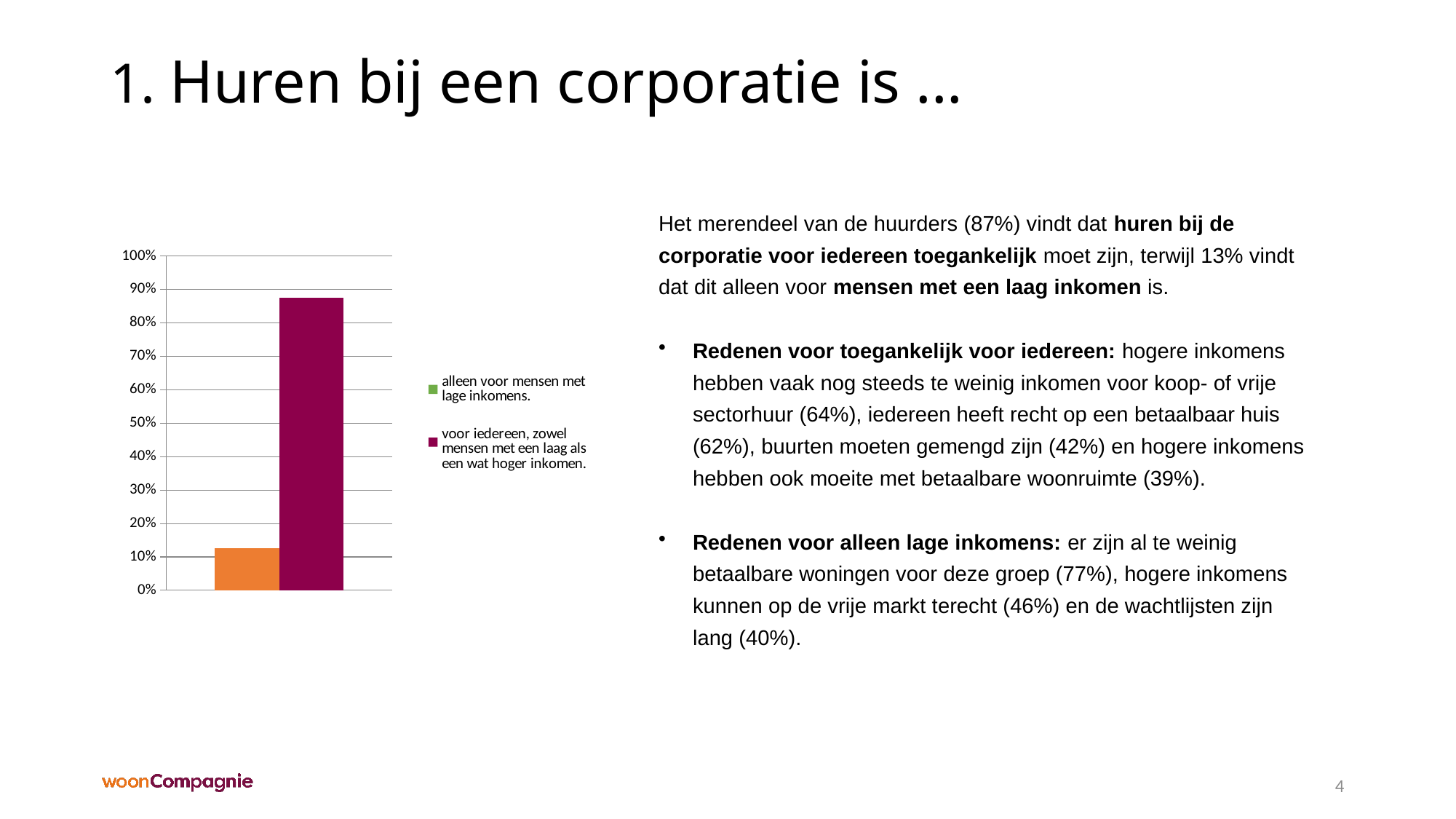
Is the value for 'alleen voor mensen met lage inkomens' greater or less than 10%? greater How many bars are plotted in the chart? 2 Is the value for 'voor iedereen, zowel mensen met een laag als een wat hoger inkomen' greater or less than 80%? greater Which series has the lowest bar in the chart? alleen voor mensen met lage inkomens. What colour is the bar for 'voor iedereen, zowel mensen met een laag als een wat hoger inkomen'? purple What kind of chart is shown on the slide? bar chart Which series has the highest bar in the chart? voor iedereen, zowel mensen met een laag als een wat hoger inkomen. Which is larger: the bar for 'alleen voor mensen met lage inkomens' or the bar for 'voor iedereen, zowel mensen met een laag als een wat hoger inkomen'? voor iedereen, zowel mensen met een laag als een wat hoger inkomen. Is the value for 'alleen voor mensen met lage inkomens' greater or less than 20%? less How many series does the chart legend list? 2 What is the highest value shown on the chart's vertical axis? 100%